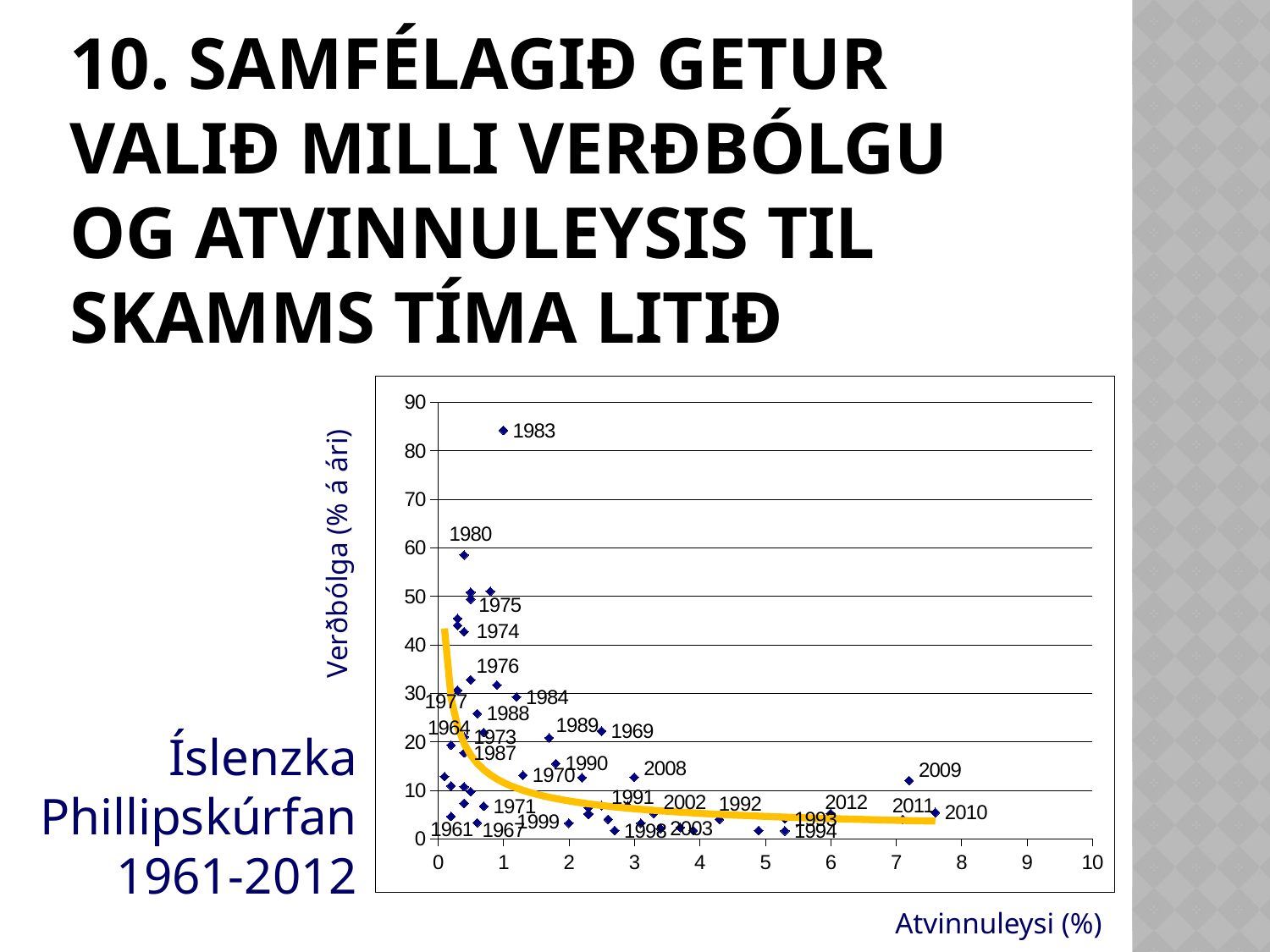
What is the label of the x axis? Atvinnuleysi (%) Is the inflation value for 1974 greater or less than 40? greater Which year has the highest unemployment value in the chart? 2010 Is the inflation value for 1994 greater or less than 10? less Which has the higher inflation value, 1983 or 1980? 1983 What kind of chart is shown on the slide? scatter chart Is the inflation value for 1983 greater or less than 80? greater Which has the higher unemployment value, 2009 or 2008? 2009 As unemployment increases along the x axis, does the fitted curve rise or fall? fall Which year has the highest inflation (Verðbólga) value in the chart? 1983